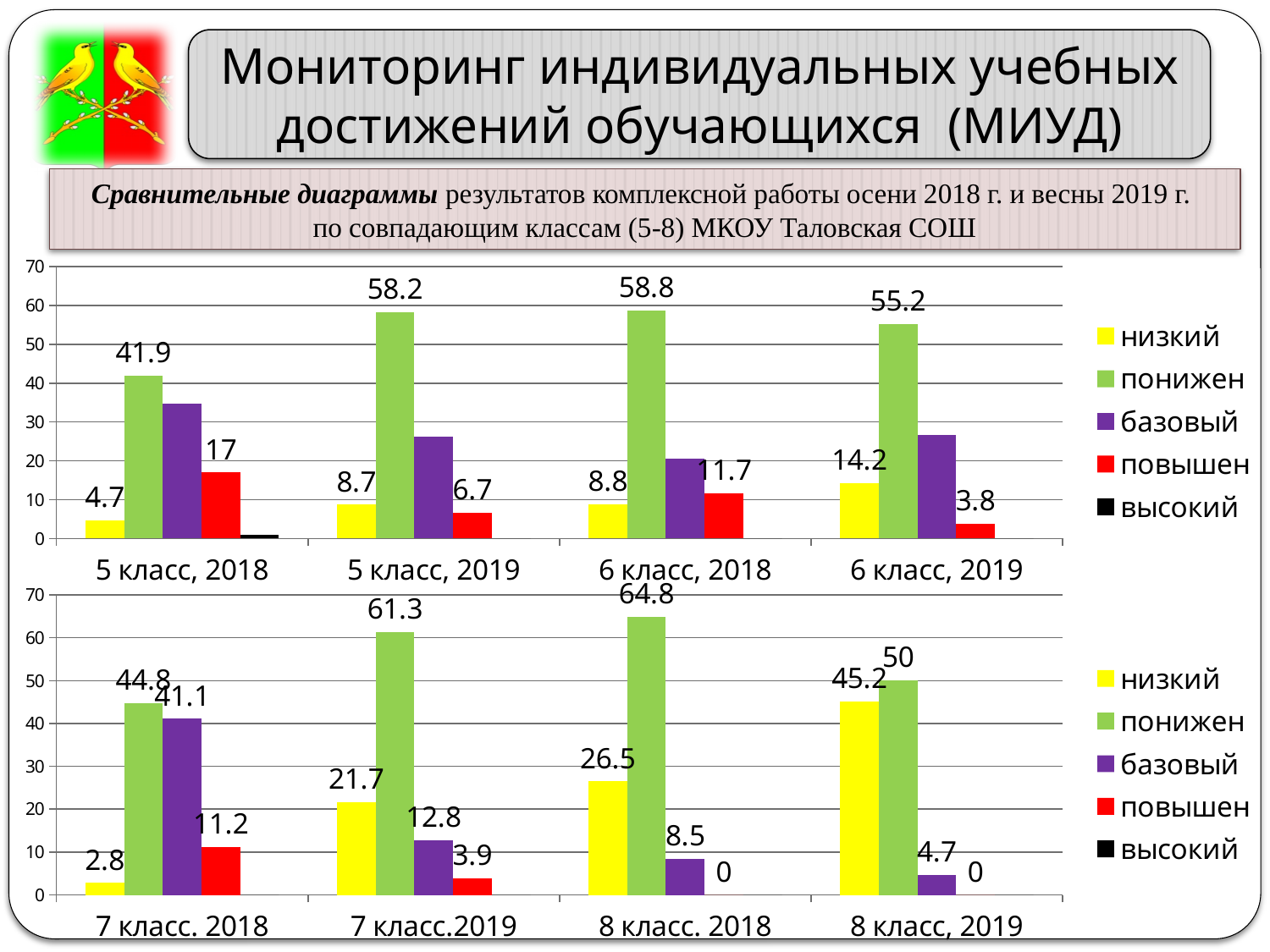
In the top chart, what is the value of низкий for 6 класс, 2019? 14.2 In the top chart, is the базовый value for 5 класс, 2018 greater or less than 30? greater In the top chart, what is the difference between the понижен values for 5 класс, 2019 and 5 класс, 2018? 16.3 In the top chart, what is the value of понижен for 5 класс, 2019? 58.2 What type of chart is the top chart? bar chart In the bottom chart, what is the value of базовый for 7 класс, 2019? 12.8 In the bottom chart, which is larger: низкий for 8 класс, 2019 or низкий for 8 класс, 2018? 8 класс, 2019 In the bottom chart, what is the value of понижен for 8 класс, 2018? 64.8 In the top chart, what is the value of повышен for 5 класс, 2018? 17 In the bottom chart, which category has the lowest низкий value? 7 класс, 2018 In the top chart, which category has the highest понижен value? 6 класс, 2018 How many series does the legend of the bottom chart list? 5